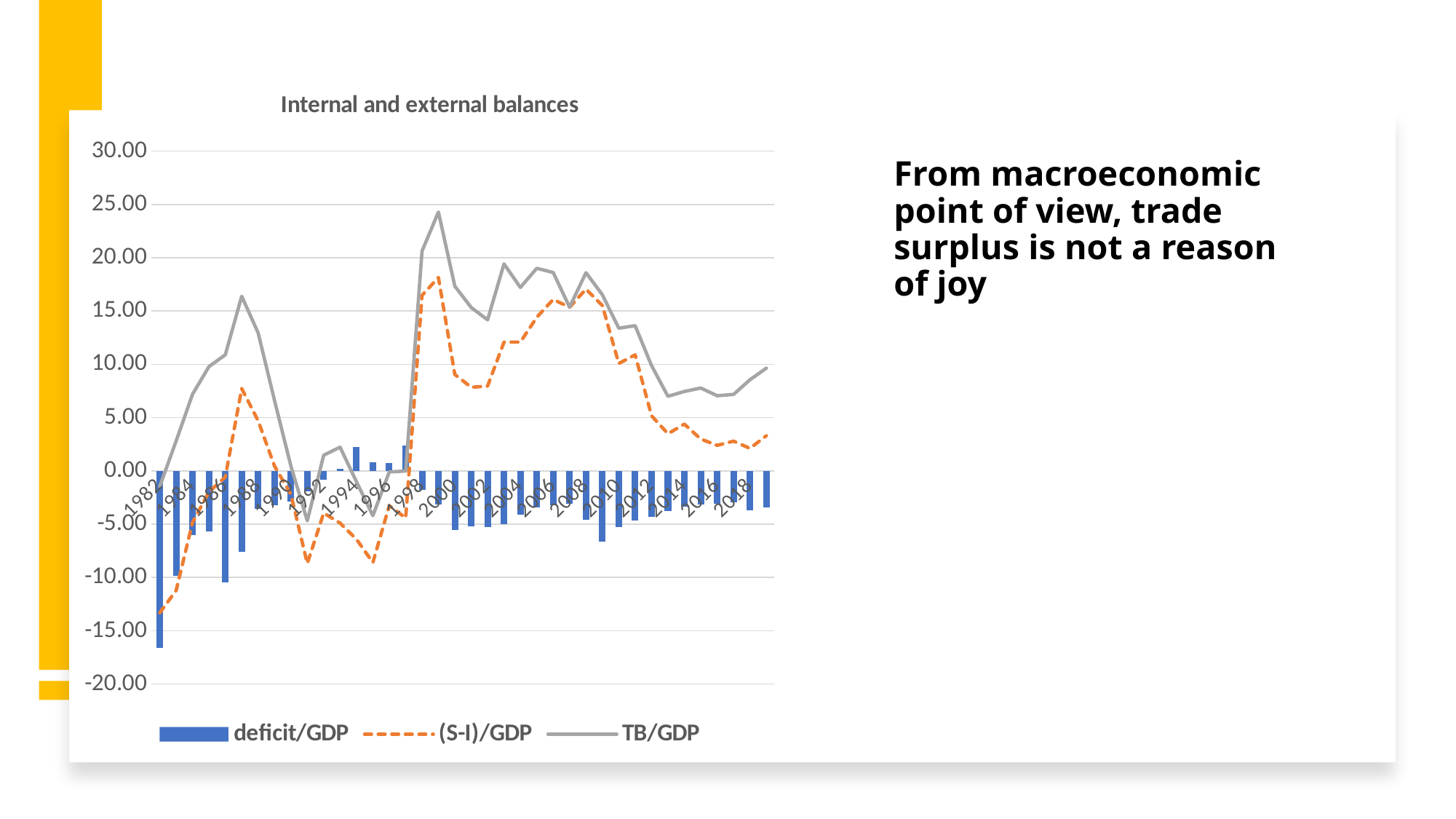
Is the TB/GDP value for 1988 greater or less than 15.00? less Is the deficit/GDP value for 2018 greater or less than -5.00? greater What is the title of the chart? Internal and external balances Which series is drawn as a dashed line? (S-I)/GDP In 2010, which is higher, TB/GDP or (S-I)/GDP? TB/GDP In which year is the deficit/GDP bar the most negative? 1982 Is the deficit/GDP value for 1982 greater or less than -15.00? less How many series does the chart's legend list? 3 What kind of chart is shown on the slide? Combined bar and line chart From 2012 to 2018, does the (S-I)/GDP line generally rise or fall? fall